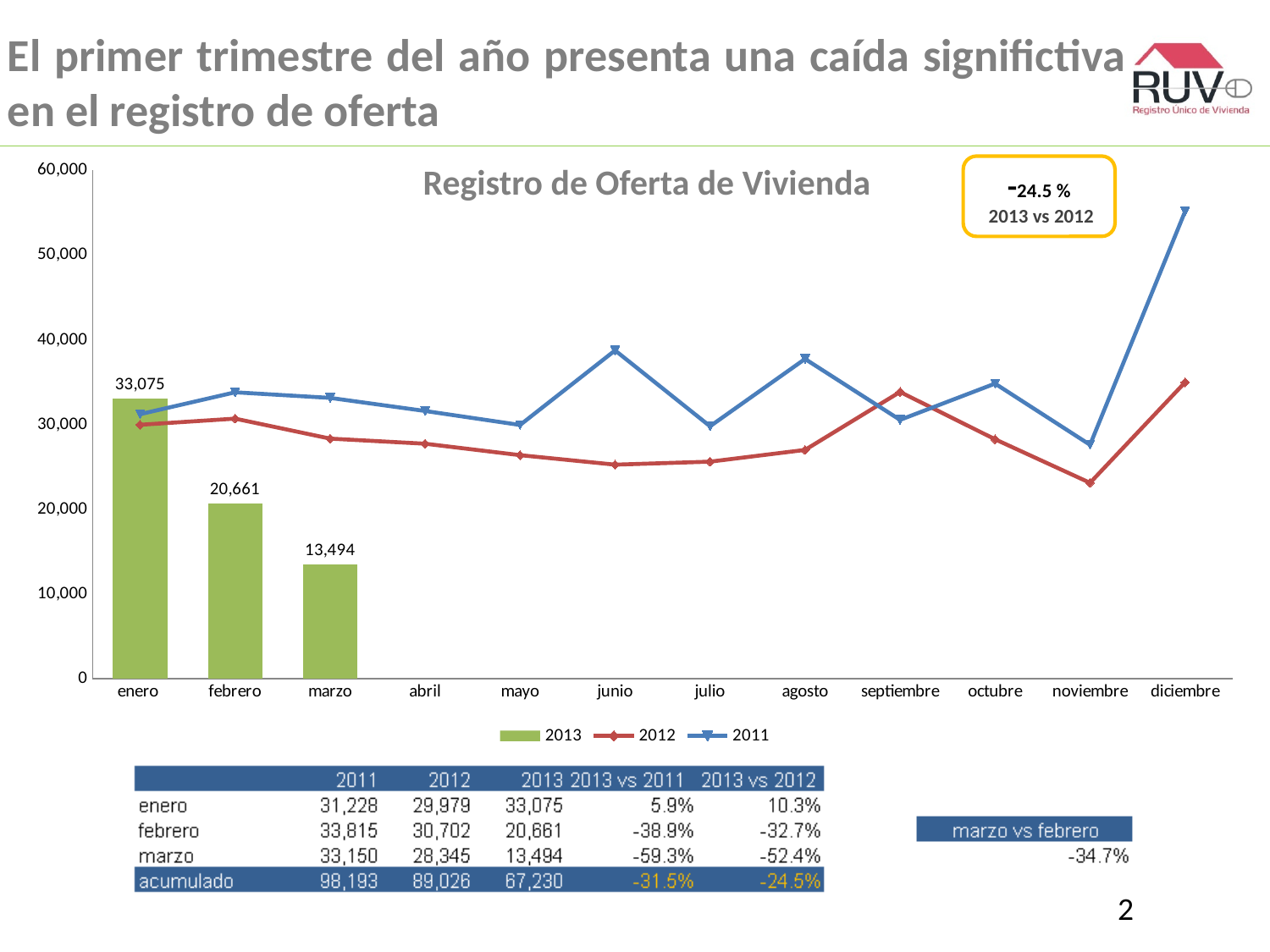
What is the value of the 2013 bar for febrero? 20,661 What is the value of the 2013 bar for enero? 33,075 Is the 2011 value for diciembre greater or less than 50,000? greater What is the value of the 2013 bar for marzo? 13,494 What is the title of the chart? Registro de Oferta de Vivienda How many months are shown on the x axis? 12 How many series does the legend list? 3 What is the difference between the 2013 values for enero and febrero? 12,414 In diciembre, which series has the larger value, 2011 or 2012? 2011 What is the difference between the 2013 values for enero and marzo? 19,581 Which month has the lowest 2013 bar? marzo Is the 2012 value for noviembre greater or less than 25,000? less